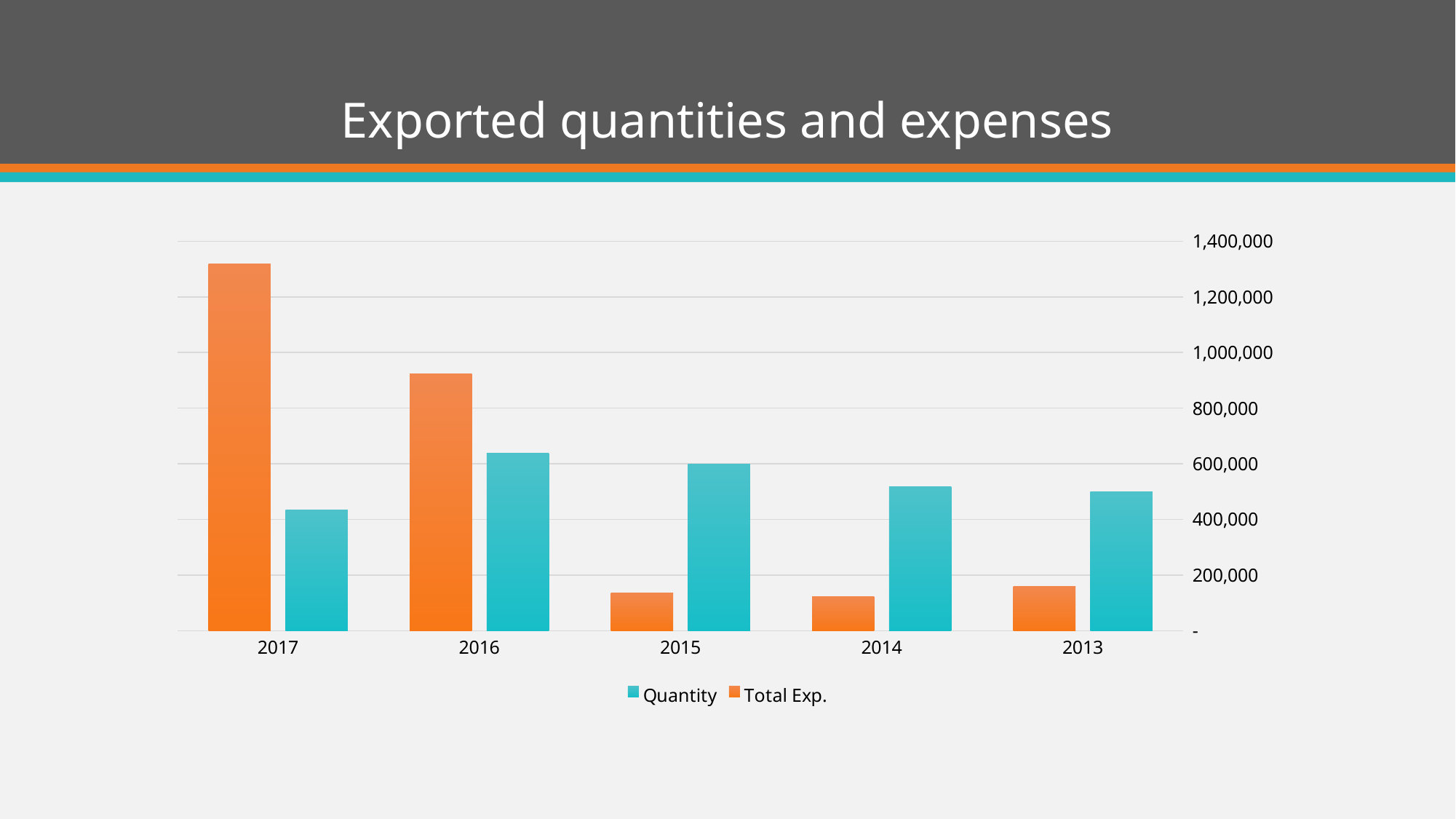
In which year is Quantity lowest? 2017 In 2017, which is larger: Quantity or Total Exp.? Total Exp. What kind of chart is shown on the slide? bar chart In 2015, which is larger: Quantity or Total Exp.? Quantity Is the Quantity value for 2016 greater or less than 600,000? greater Is the Total Exp. value for 2017 greater or less than 1,200,000? greater Is the Total Exp. value for 2015 greater or less than 200,000? less In which year is Quantity highest? 2016 How many years are shown on the x axis? 5 In which year is Total Exp. highest? 2017 How many series does the legend list? 2